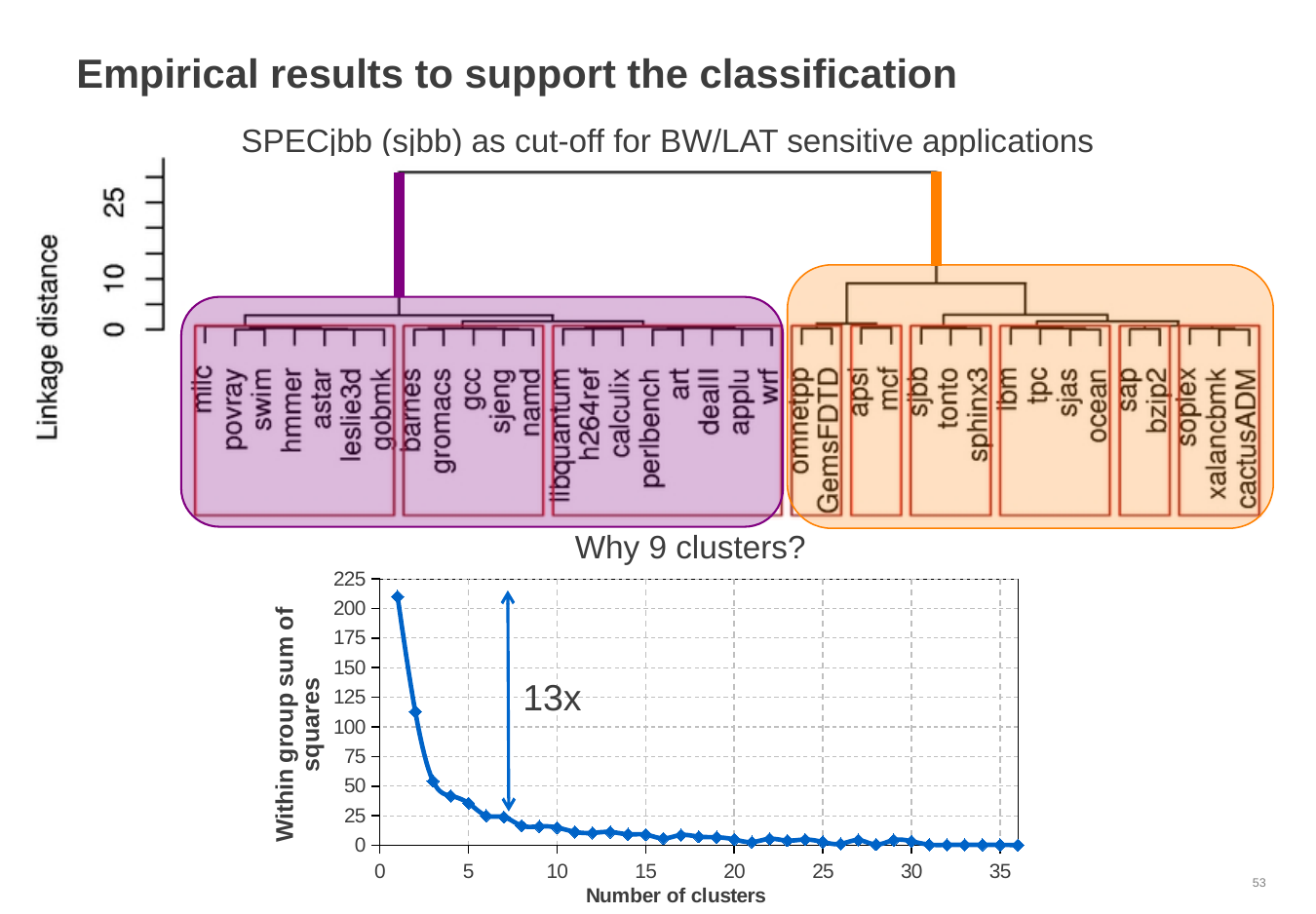
In the bottom chart "Why 9 clusters?", what factor is written next to the vertical arrow? 13x In the bottom chart "Why 9 clusters?", is the value at 10 clusters greater or less than 25? less What type of chart is the bottom chart titled "Why 9 clusters?"? line chart In the bottom chart "Why 9 clusters?", is the value at 1 cluster greater or less than 200? greater In the bottom chart "Why 9 clusters?", do the values rise or fall as the number of clusters increases? fall In the bottom chart "Why 9 clusters?", is the value at 2 clusters greater or less than 100? greater In the top dendrogram chart, how many boxed clusters are outlined in total across the purple and orange groups? 9 In the bottom chart "Why 9 clusters?", what is the label of the x axis? Number of clusters In the bottom chart "Why 9 clusters?", which has the larger within group sum of squares: 1 cluster or 3 clusters? 1 cluster In the bottom chart "Why 9 clusters?", what is the label of the y axis? Within group sum of squares